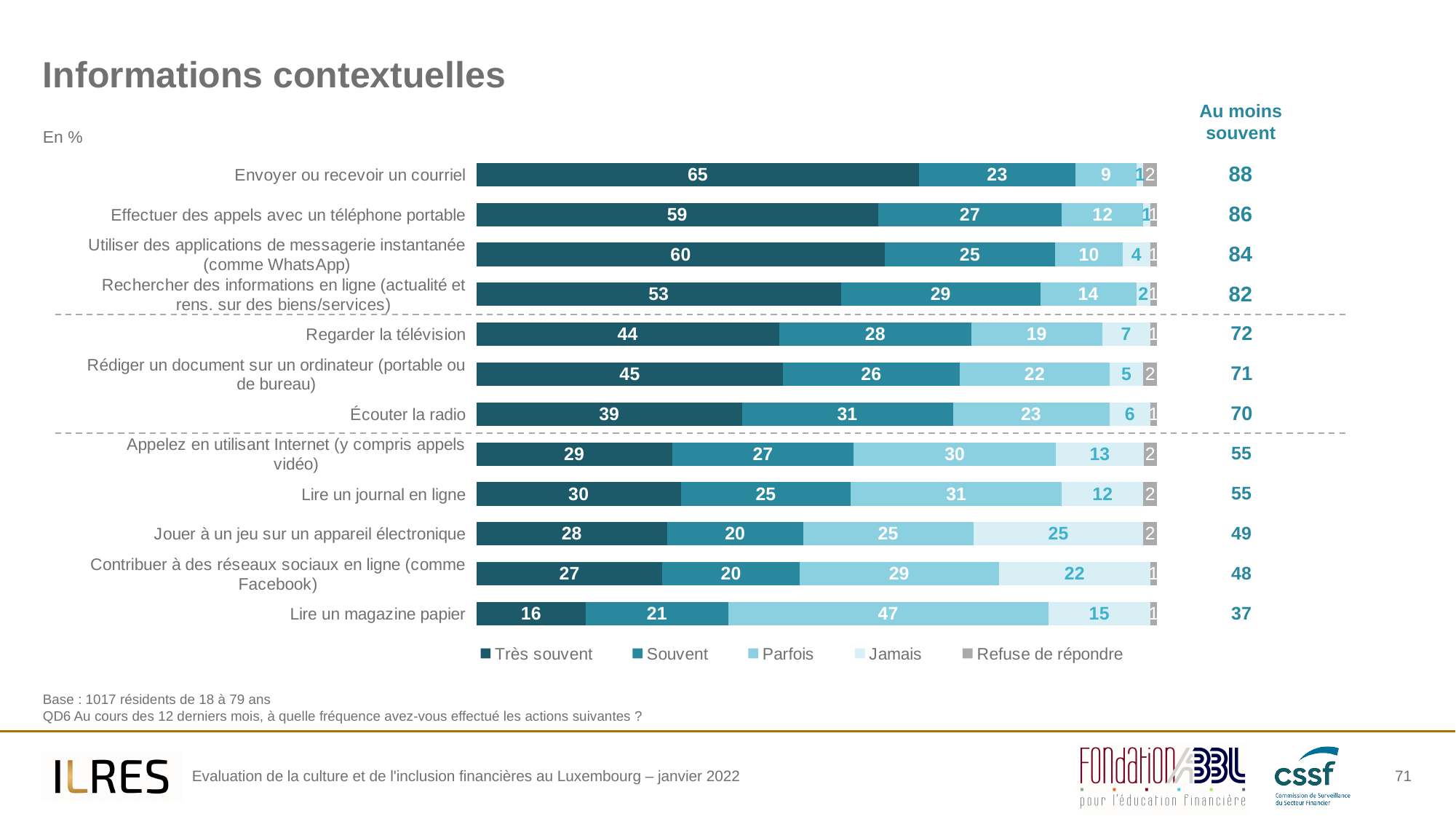
What is the value for "Très souvent" for "Envoyer ou recevoir un courriel"? 65 Which has the larger "Jamais" value: "Jouer à un jeu sur un appareil électronique" or "Contribuer à des réseaux sociaux en ligne (comme Facebook)"? Jouer à un jeu sur un appareil électronique What is the "Au moins souvent" value for "Regarder la télévision"? 72 How many categories (activities) are shown in the chart? 12 What is the combined total of "Très souvent" and "Souvent" for "Lire un magazine papier"? 37 What is the value for "Parfois" for "Lire un magazine papier"? 47 What is the difference between the "Souvent" value for "Écouter la radio" and the "Souvent" value for "Regarder la télévision"? 3 Which category has the lowest "Très souvent" value? Lire un magazine papier How many series does the legend list? 5 What is the value for "Jamais" for "Appelez en utilisant Internet (y compris appels vidéo)"? 13 Which category has the highest "Très souvent" value? Envoyer ou recevoir un courriel What kind of chart is shown on the slide? Stacked bar chart